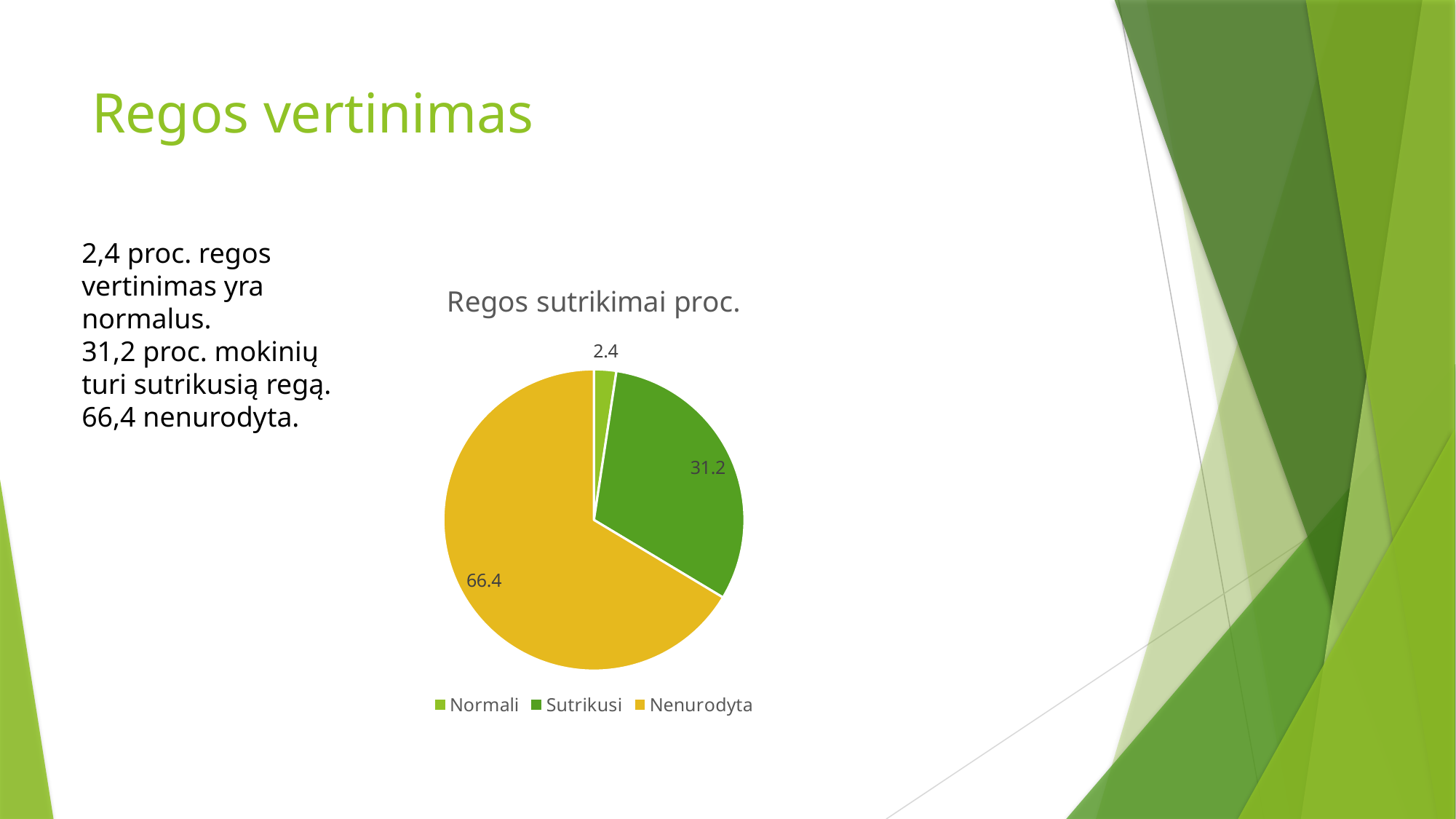
What is the value for Sutrikusi in the pie chart? 31.2 Which category has the largest slice of the pie chart? Nenurodyta Which category has the smallest slice of the pie chart? Normali What is the value for Normali in the pie chart? 2.4 What is the difference between the values for Sutrikusi and Normali? 28.8 What kind of chart is shown on the slide? Pie chart Which is larger, the value for Sutrikusi or the value for Normali? Sutrikusi How many slices does the pie chart have? 3 What is the title of the chart? Regos sutrikimai proc. Which category is shown in yellow in the pie chart? Nenurodyta What is the difference between the values for Nenurodyta and Sutrikusi? 35.2 What is the value for Nenurodyta in the pie chart? 66.4